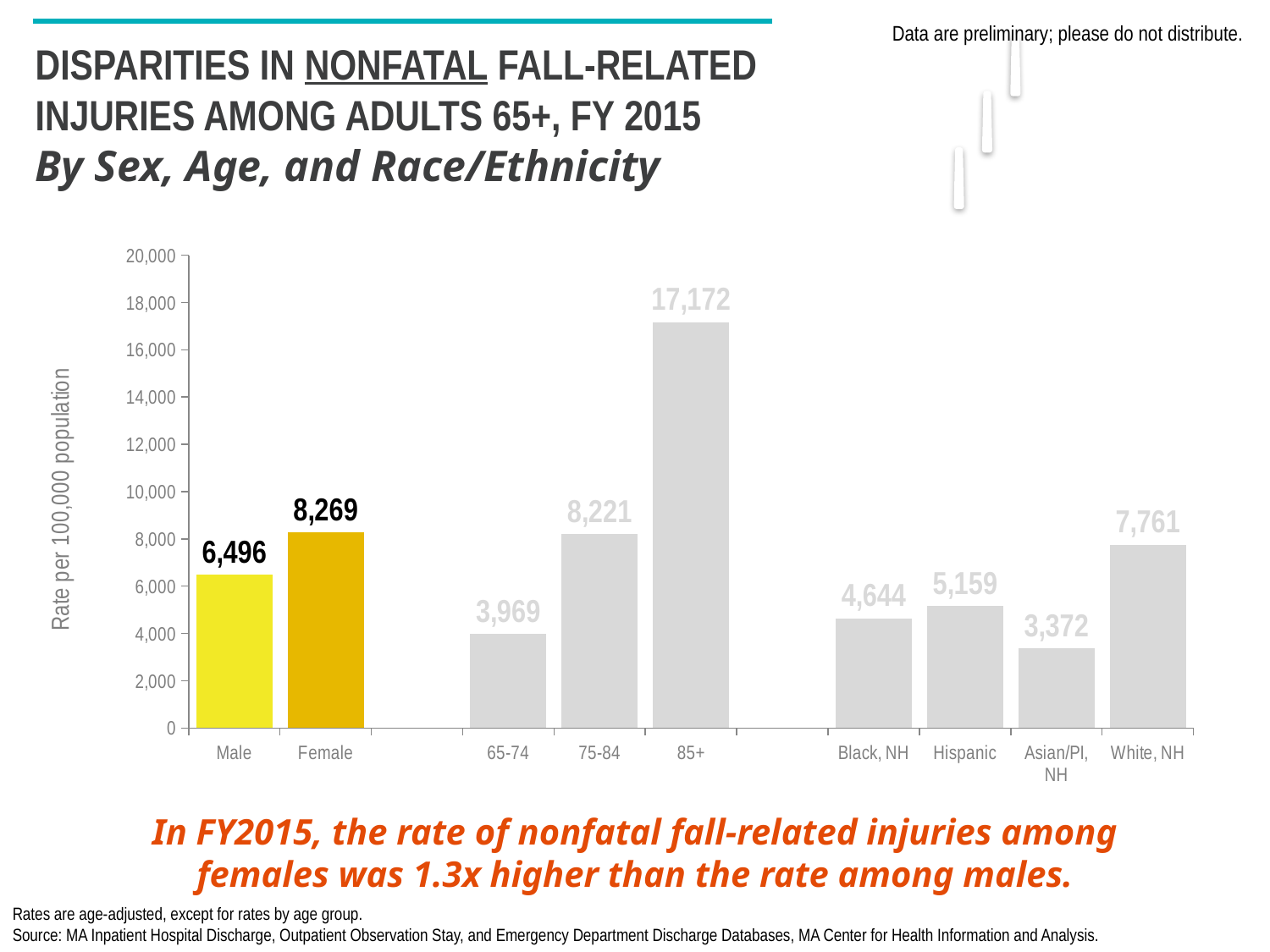
What is the rate of nonfatal fall-related injuries for males? 6,496 Is the rate for White, NH greater or less than 8,000? less What is the rate for Asian/PI, NH? 3,372 What is the difference between the female rate and the male rate? 1,773 What is the rate of nonfatal fall-related injuries for females? 8,269 Which category has the lowest rate on the chart? Asian/PI, NH How many categories are shown on the x axis? 9 Do the rates rise or fall across the age groups from 65-74 to 85+? rise What is the rate for the 85+ age group? 17,172 Which has a higher rate, Hispanic or Black, NH? Hispanic Which category has the highest rate on the chart? 85+ What kind of chart is shown on the slide? bar chart